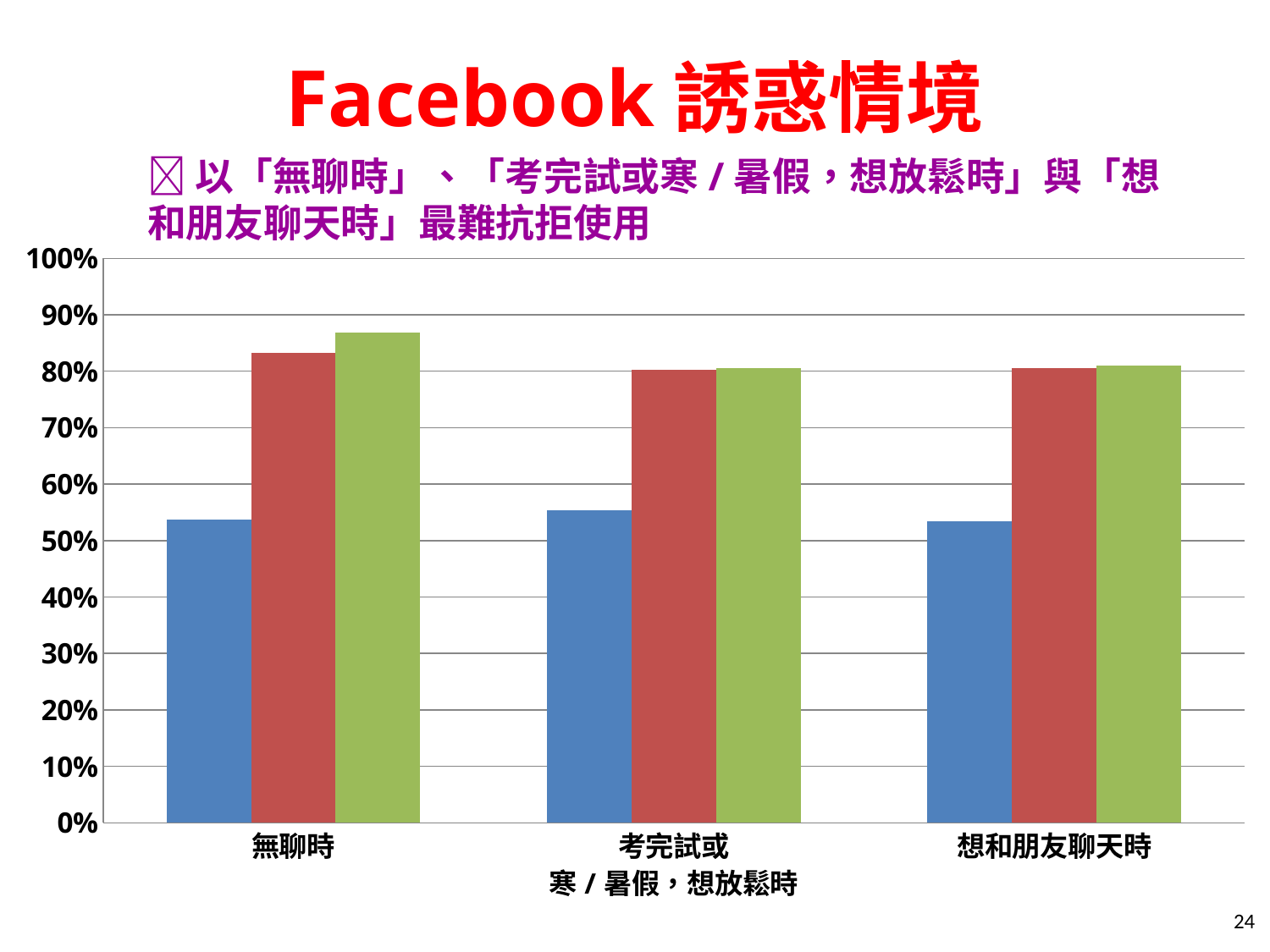
What kind of chart is shown on the slide? bar chart How many categories are shown on the x axis of the chart? 3 Which category has the highest green bar? 無聊時 How many bars are shown for each category in the chart? 3 Is the value of the blue bar for 想和朋友聊天時 greater or less than 60%? less For 考完試或寒／暑假，想放鬆時, which is larger: the blue bar or the red bar? the red bar Is the value of the green bar for 無聊時 greater or less than 80%? greater What is the title of the slide containing the chart? Facebook 誘惑情境 Is the value of the blue bar for 無聊時 greater or less than 50%? greater Which category has the highest red bar? 無聊時